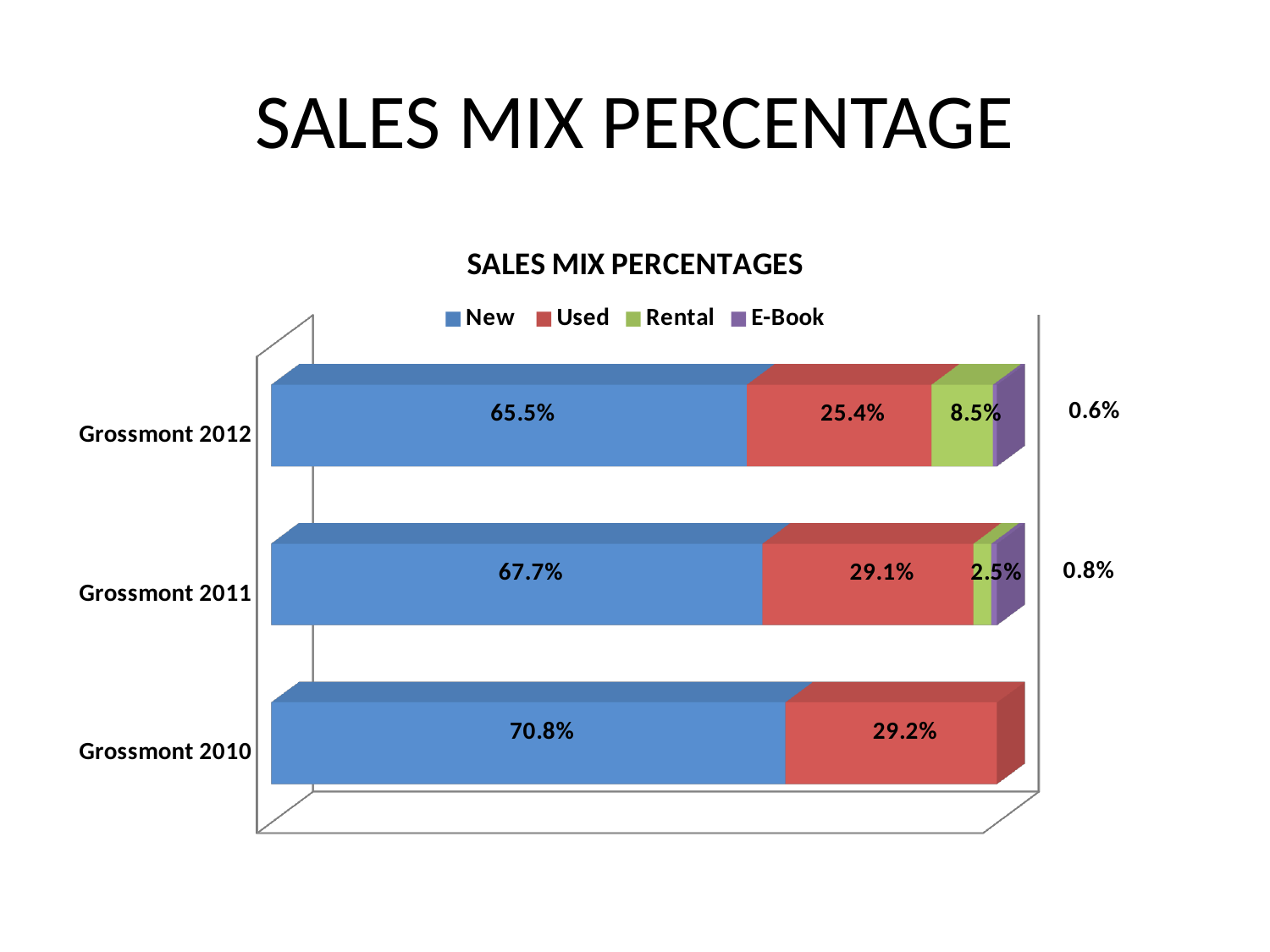
What is the difference between the New percentage for Grossmont 2010 and Grossmont 2012? 5.3% What is the Used sales mix percentage for Grossmont 2010? 29.2% Which year has the lowest New sales mix percentage? Grossmont 2012 Which year has the highest New sales mix percentage? Grossmont 2010 Which is larger, the Rental percentage for Grossmont 2012 or for Grossmont 2011? Grossmont 2012 How many series does the legend list? 4 What is the E-Book sales mix percentage for Grossmont 2011? 0.8% What is the New sales mix percentage for Grossmont 2012? 65.5% How many categories (years) are shown on the chart? 3 What kind of chart is shown on the slide? Stacked bar chart What is the Rental sales mix percentage for Grossmont 2012? 8.5% What is the Used sales mix percentage for Grossmont 2011? 29.1%